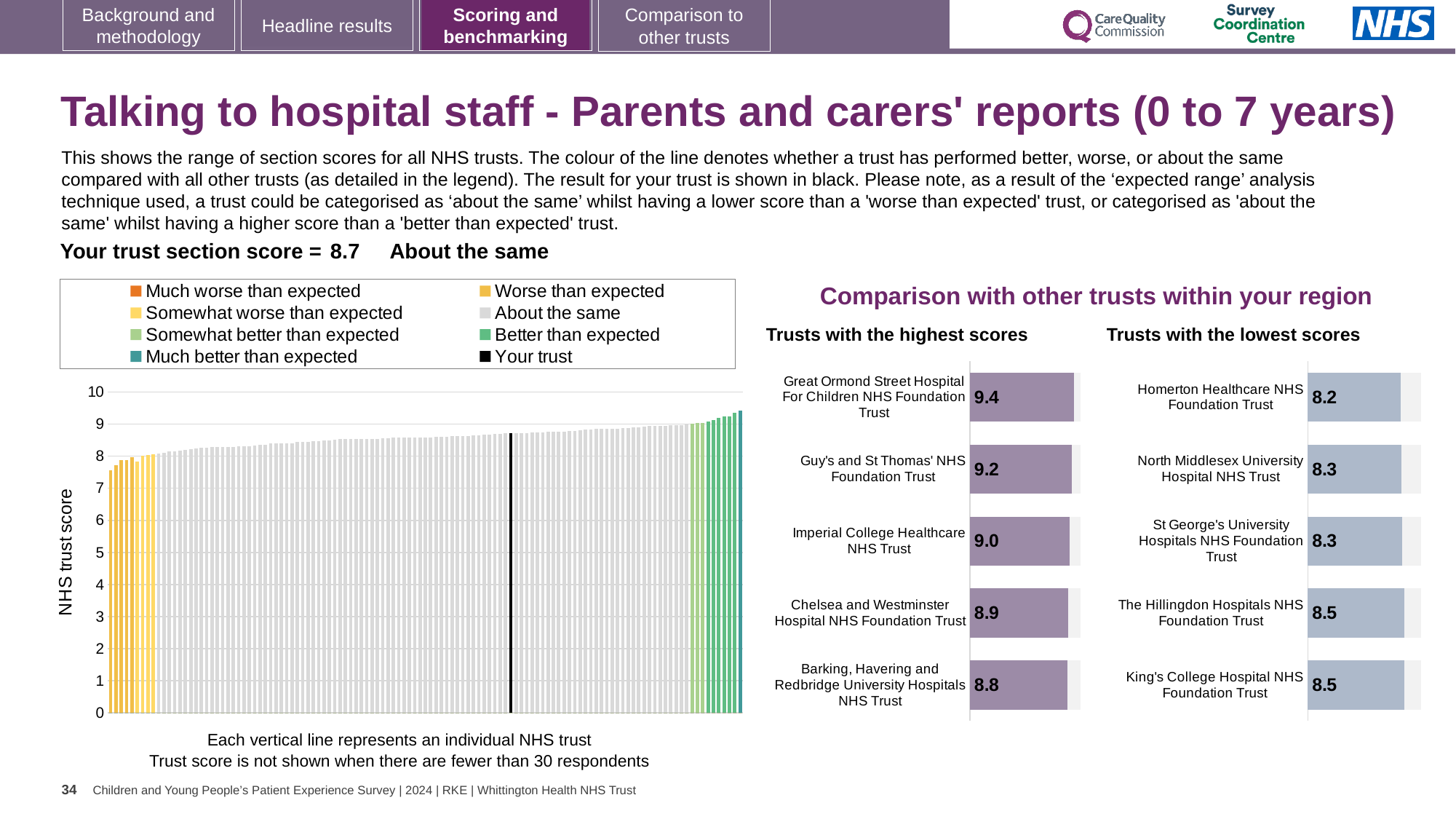
What kind of chart is the large 'NHS trust score' chart on the left of the slide? bar chart How many trusts are shown in the 'Trusts with the lowest scores' chart? 5 In the large 'NHS trust score' chart on the left, is the value for the black 'Your trust' line greater or less than 5? greater In the 'Trusts with the highest scores' chart, what is the score for Great Ormond Street Hospital For Children NHS Foundation Trust? 9.4 In the 'Trusts with the lowest scores' chart, what is the difference between the scores of The Hillingdon Hospitals NHS Foundation Trust and Homerton Healthcare NHS Foundation Trust? 0.3 In the 'Trusts with the highest scores' chart, what is the difference between the scores of Great Ormond Street Hospital For Children NHS Foundation Trust and Barking, Havering and Redbridge University Hospitals NHS Trust? 0.6 In the 'Trusts with the highest scores' chart, which trust has the highest score? Great Ormond Street Hospital For Children NHS Foundation Trust In the 'Trusts with the lowest scores' chart, which trust has the lowest score? Homerton Healthcare NHS Foundation Trust How many entries does the legend of the large 'NHS trust score' chart on the left list? 8 In the 'Trusts with the lowest scores' chart, what is the score for Homerton Healthcare NHS Foundation Trust? 8.2 In the large 'NHS trust score' chart on the left, do the values rise or fall from left to right? rise In the 'Trusts with the highest scores' chart, which has the higher score: Guy's and St Thomas' NHS Foundation Trust or Imperial College Healthcare NHS Trust? Guy's and St Thomas' NHS Foundation Trust